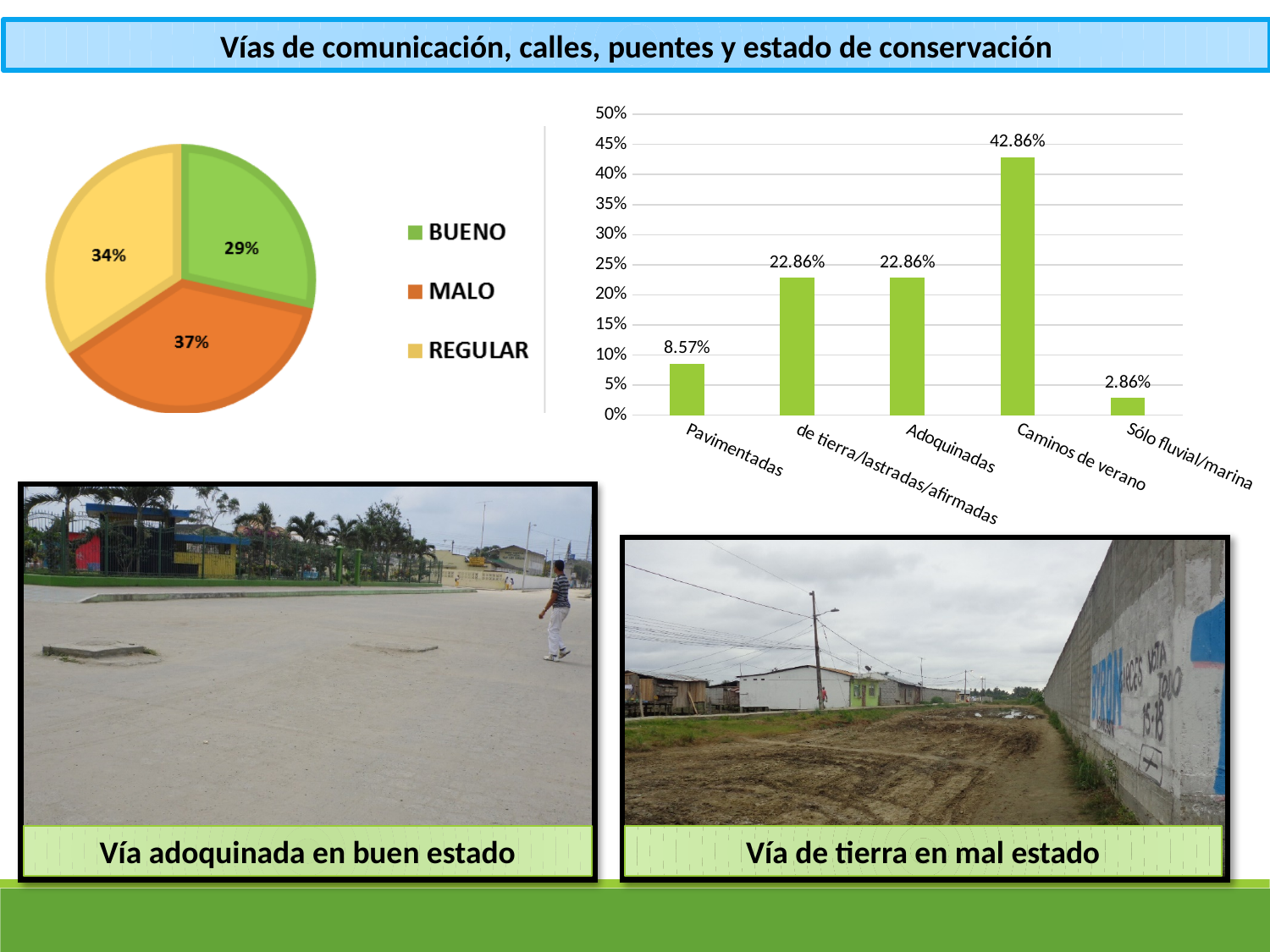
In the bar chart on the right, what is the difference between Caminos de verano and Adoquinadas? 20.00% In the pie chart on the left, which category has the smallest share? BUENO In the bar chart on the right, which category has the lowest value? Sólo fluvial/marina In the pie chart on the left, what percentage is labelled MALO? 37% In the bar chart on the right, what is the value for Pavimentadas? 8.57% What kind of chart is shown on the right side of the slide? Bar chart In the pie chart on the left, what is the difference between the REGULAR and BUENO shares? 5% In the pie chart on the left, how many categories does the legend list? 3 In the pie chart on the left, what percentage is labelled BUENO? 29% In the bar chart on the right, what is the value for Caminos de verano? 42.86% In the bar chart on the right, how many categories are shown on the x axis? 5 In the pie chart on the left, which category has the largest share? MALO